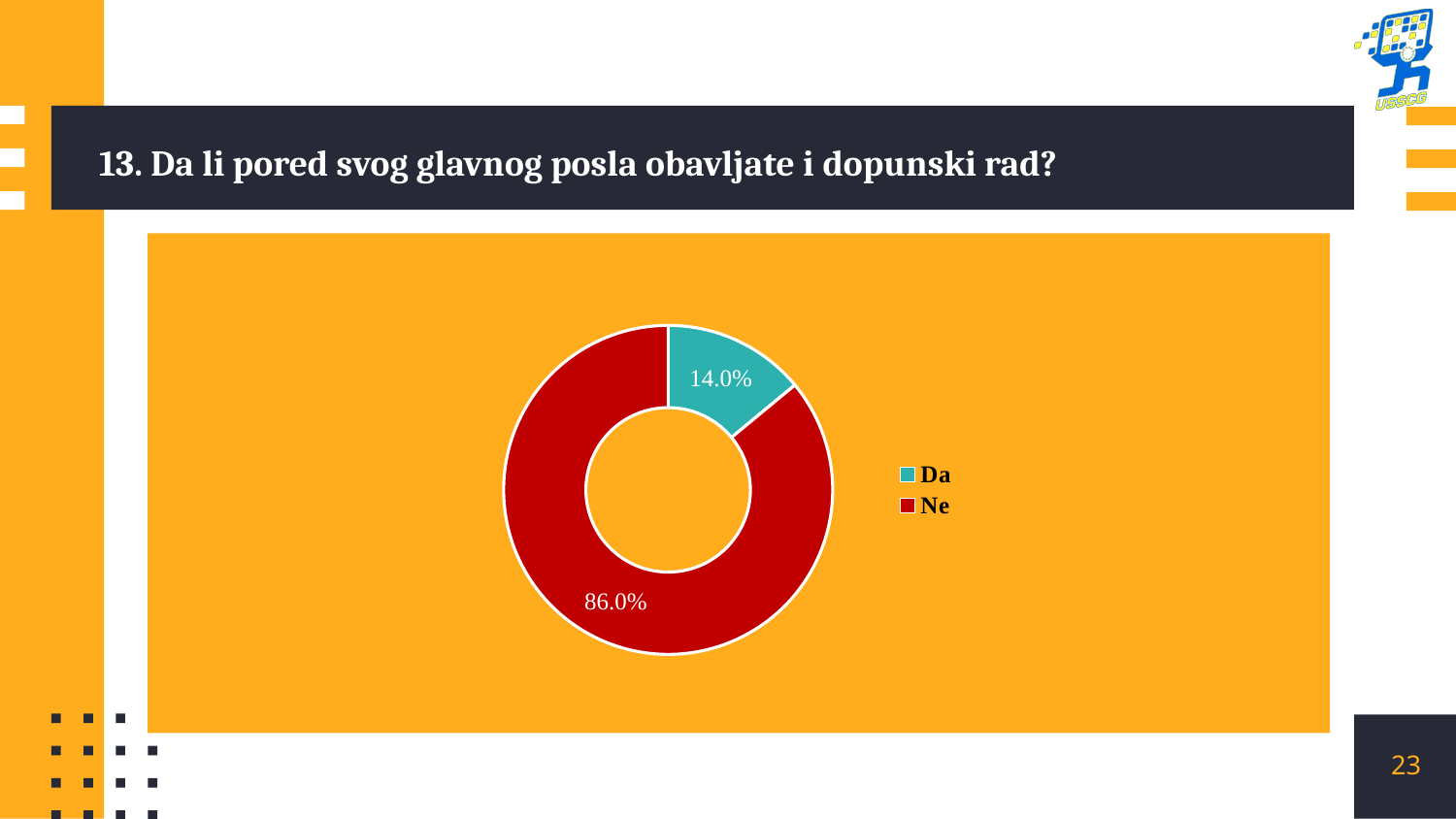
What is the question shown as the slide title? 13. Da li pored svog glavnog posla obavljate i dopunski rad? What colour is the "Da" slice? Teal What percentage of respondents answered "Da"? 14.0% What share of the chart does the "Ne" slice represent? 86.0% How many categories does the chart show? 2 What percentage of respondents answered "Ne"? 86.0% Which answer has the largest share of the chart? Ne Which answer has the smallest share of the chart? Da What kind of chart is shown on the slide? Doughnut (pie) chart What is the difference in percentage points between the "Ne" and "Da" shares? 72.0 Which is larger, the share for "Da" or the share for "Ne"? Ne How many entries does the legend list? 2